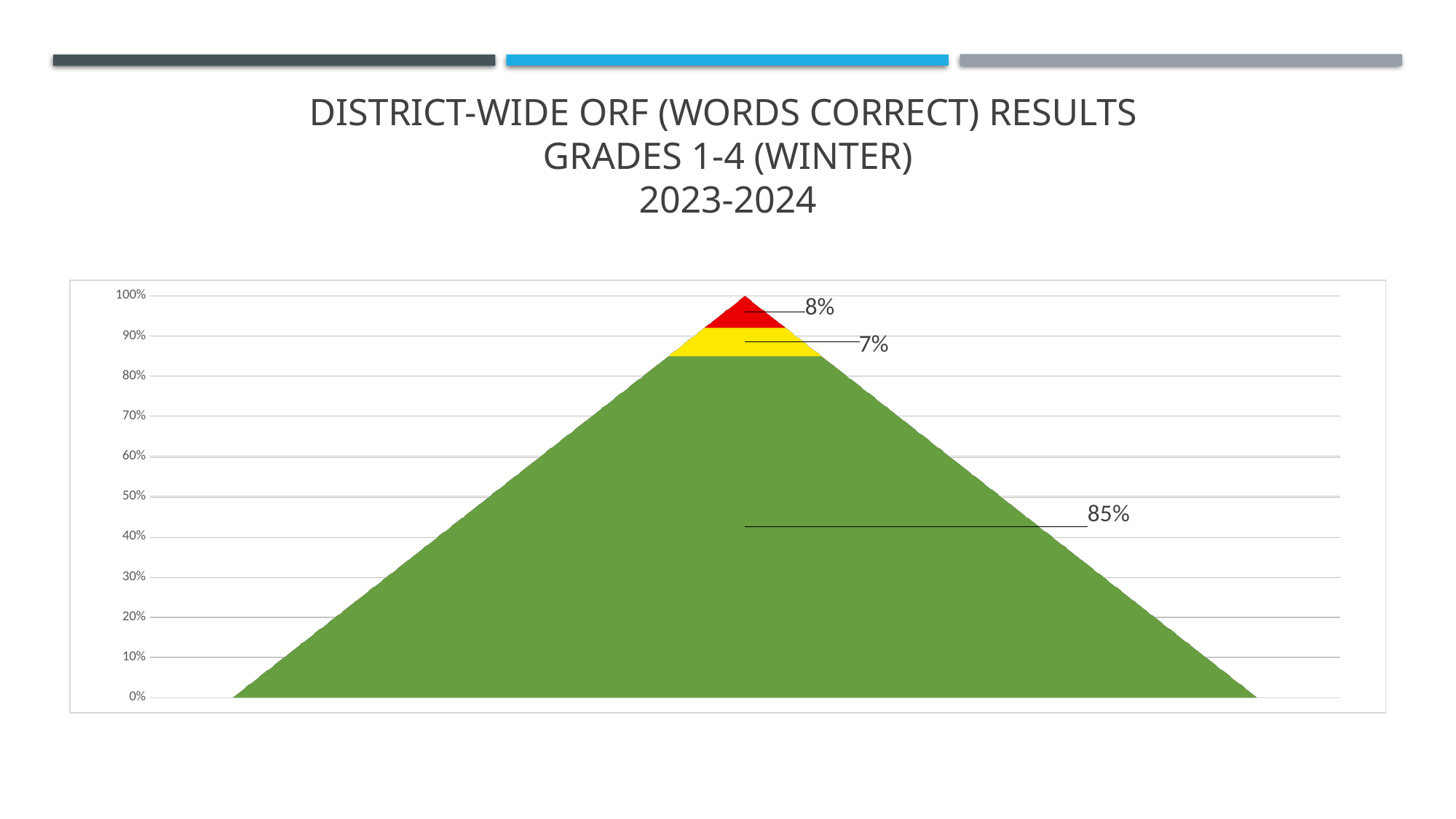
Which coloured segment of the pyramid has the largest value? Green Is the value for the green segment greater or less than 80%? greater What value is labelled on the red segment at the top of the pyramid? 8% What is the difference between the red segment's value and the yellow segment's value? 1 percentage point What value is labelled on the yellow segment of the pyramid? 7% Which coloured segment of the pyramid has the smallest value? Yellow What value is labelled on the green segment of the pyramid? 85% What is the difference between the green segment's value and the yellow segment's value? 78 percentage points What do the three labelled segment values add up to? 100% What is the title of the chart on this slide? District-Wide ORF (Words Correct) Results Grades 1-4 (Winter) 2023-2024 Which is larger, the red segment's value or the yellow segment's value? Red How many coloured segments make up the pyramid? 3